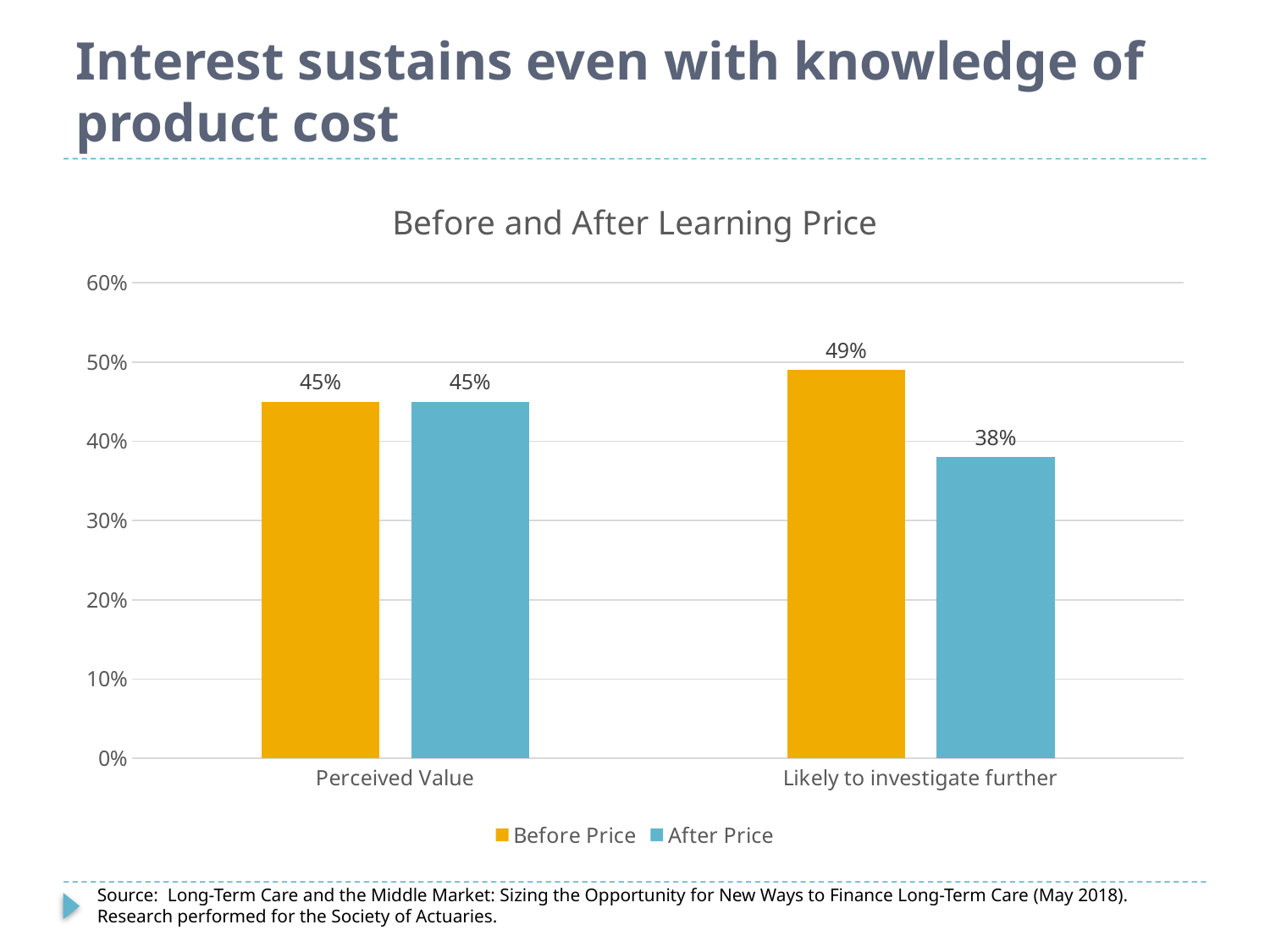
Which category has the lowest After Price value? Likely to investigate further How many categories are shown on the x axis? 2 For Likely to investigate further, which is larger: the Before Price value or the After Price value? Before Price What is the After Price value for Likely to investigate further? 38% What type of chart is shown on the slide? Bar chart What is the Before Price value for Likely to investigate further? 49% What is the After Price value for Perceived Value? 45% What is the difference between the Before Price and After Price values for Likely to investigate further? 11% What is the Before Price value for Perceived Value? 45% How many series does the legend list? 2 Is the After Price value for Likely to investigate further greater or less than 40%? less Which category has the highest Before Price value? Likely to investigate further